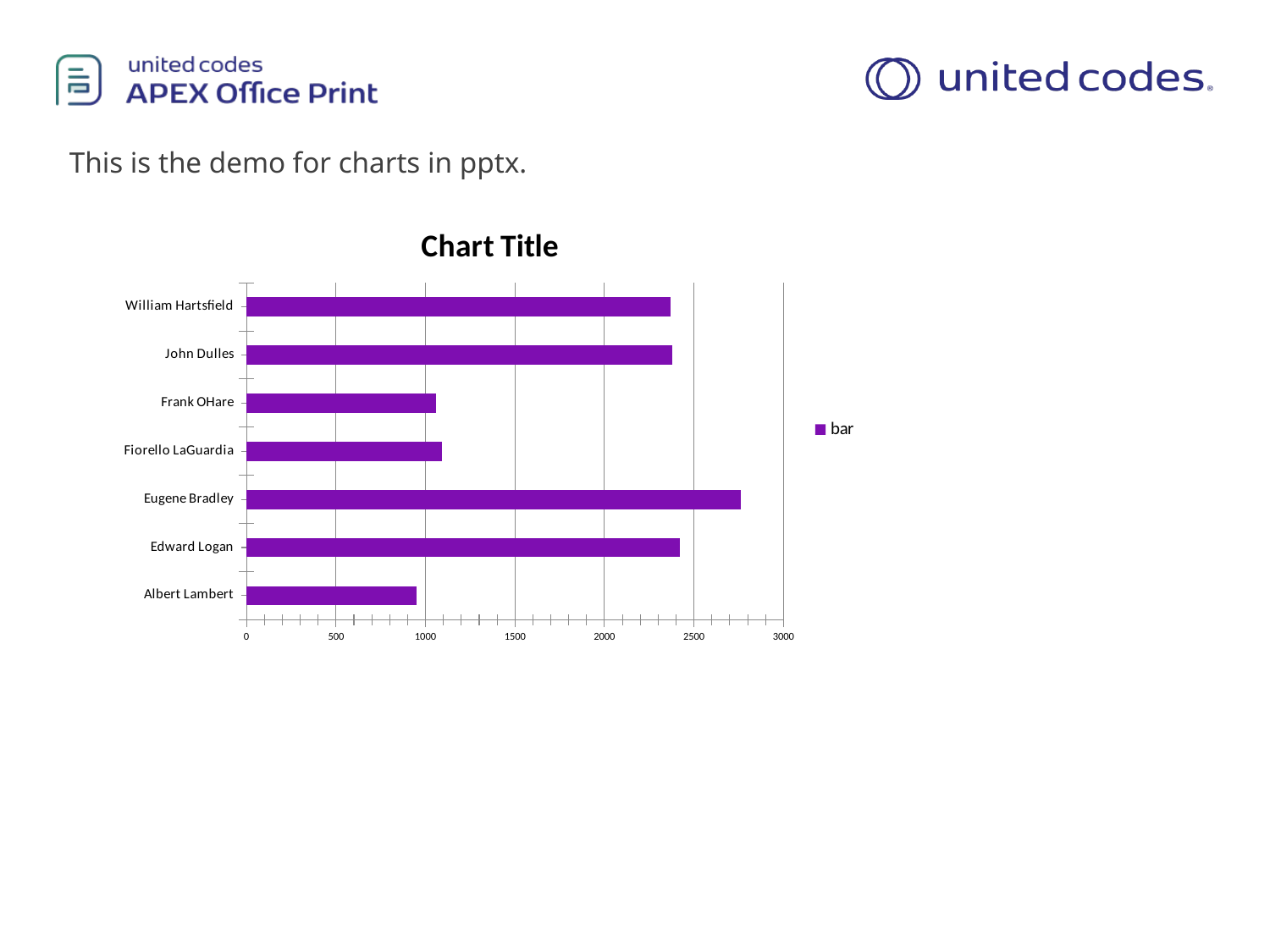
Is the value for Albert Lambert greater or less than 1000? less How many categories are plotted on the chart? 7 What is the name of the series shown in the legend? bar Which is larger, the value for Edward Logan or the value for Frank OHare? Edward Logan How many series does the legend list? 1 Which category has the highest value? Eugene Bradley What kind of chart is shown on the slide? bar chart Which category has the lowest value? Albert Lambert Is the value for Edward Logan greater or less than 2500? less What is the title of the chart? Chart Title Is the value for William Hartsfield greater or less than 2000? greater